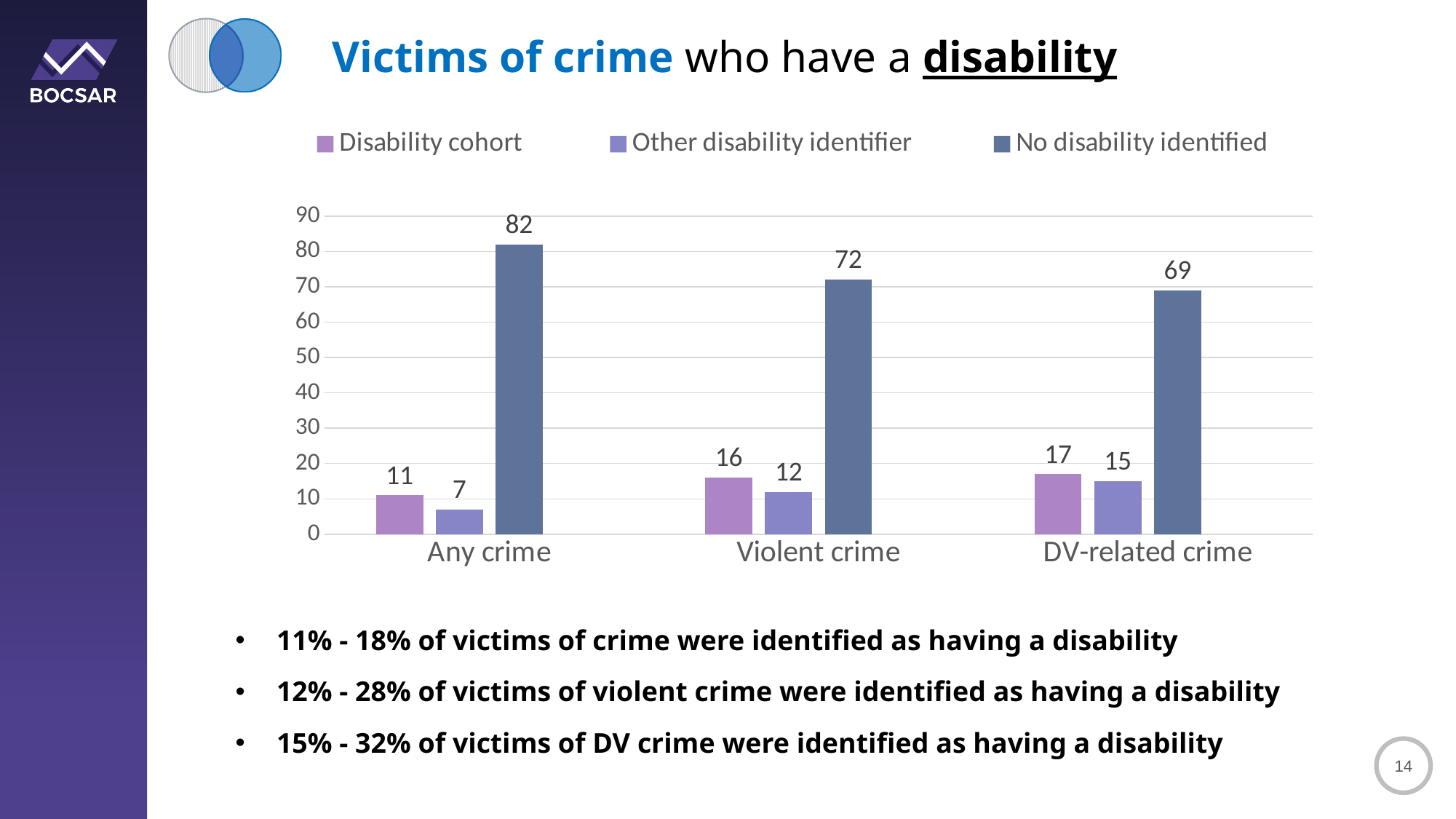
What is the difference between the No disability identified values for Any crime and DV-related crime? 13 Which legend entry is shown in the darkest colour? No disability identified Which category has the lowest value for Other disability identifier? Any crime How many categories are shown on the x axis? 3 What is the value for Disability cohort in the Violent crime category? 16 Which category has the highest value for No disability identified? Any crime How many series does the legend list? 3 Which is larger: the Disability cohort value for DV-related crime or the Disability cohort value for Any crime? DV-related crime What is the value for Other disability identifier in the DV-related crime category? 15 What is the value for No disability identified in the Any crime category? 82 What kind of chart is shown on the slide? Bar chart Do the No disability identified values rise or fall from Any crime to DV-related crime? Fall